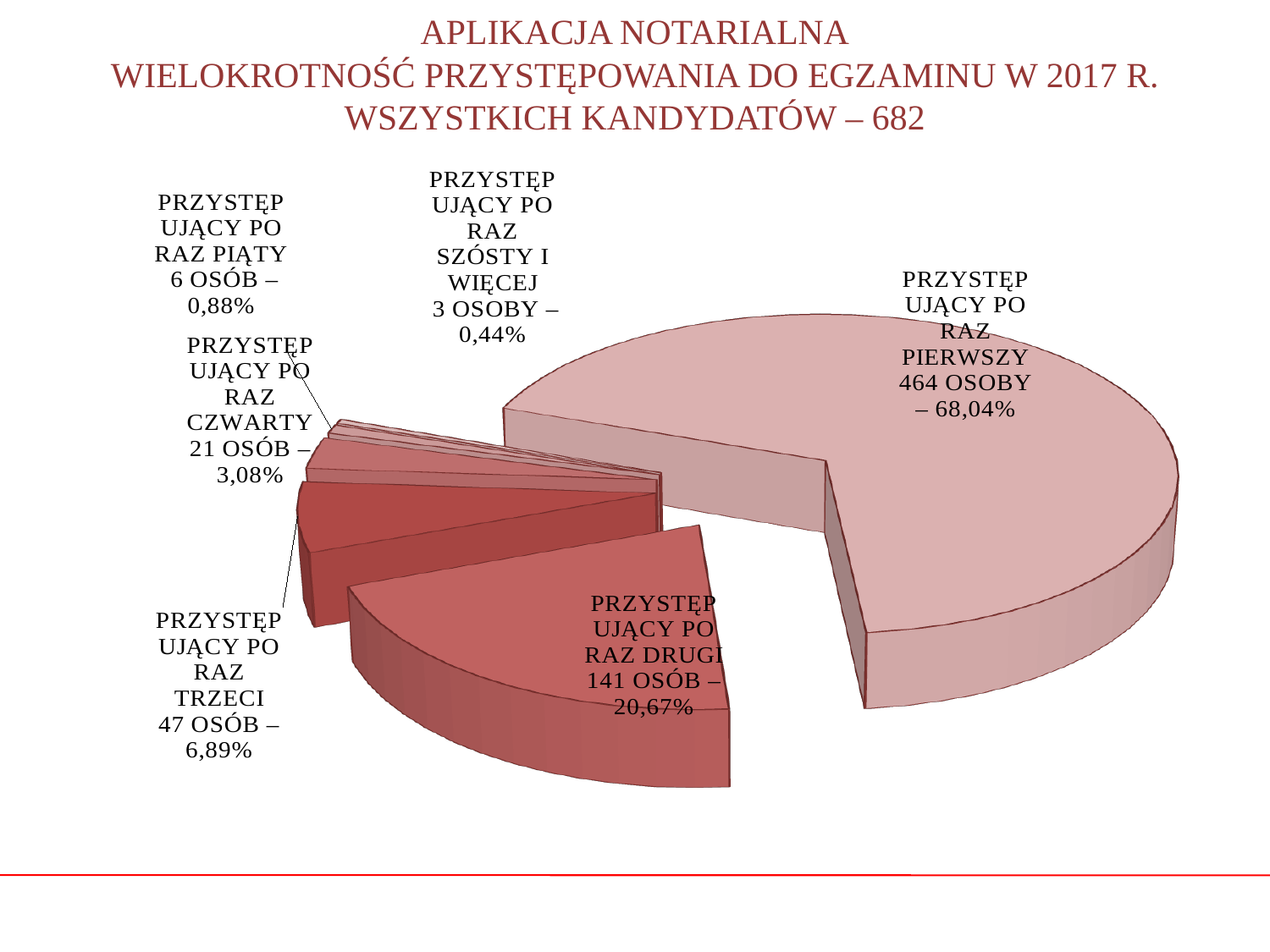
According to the chart title, what is the total number of candidates? 682 How many slices does the pie chart have? 6 Which category has the smallest slice of the pie? PRZYSTĘPUJĄCY PO RAZ SZÓSTY I WIĘCEJ What kind of chart is shown on the slide? pie chart What percentage is shown for candidates taking the exam for the fourth time (PRZYSTĘPUJĄCY PO RAZ CZWARTY)? 3,08% Which group is larger: candidates taking the exam for the third time or for the fifth time? PRZYSTĘPUJĄCY PO RAZ TRZECI How many candidates took the exam for the first time (PRZYSTĘPUJĄCY PO RAZ PIERWSZY)? 464 OSOBY What share of the pie is taken by candidates taking the exam for the second time (PRZYSTĘPUJĄCY PO RAZ DRUGI)? 20,67% How many candidates took the exam for the sixth time or more (PRZYSTĘPUJĄCY PO RAZ SZÓSTY I WIĘCEJ)? 3 OSOBY What is the difference in the number of candidates between those taking the exam for the first time and those taking it for the second time? 323 Which category has the largest slice of the pie? PRZYSTĘPUJĄCY PO RAZ PIERWSZY How many candidates took the exam for the third time (PRZYSTĘPUJĄCY PO RAZ TRZECI)? 47 OSÓB